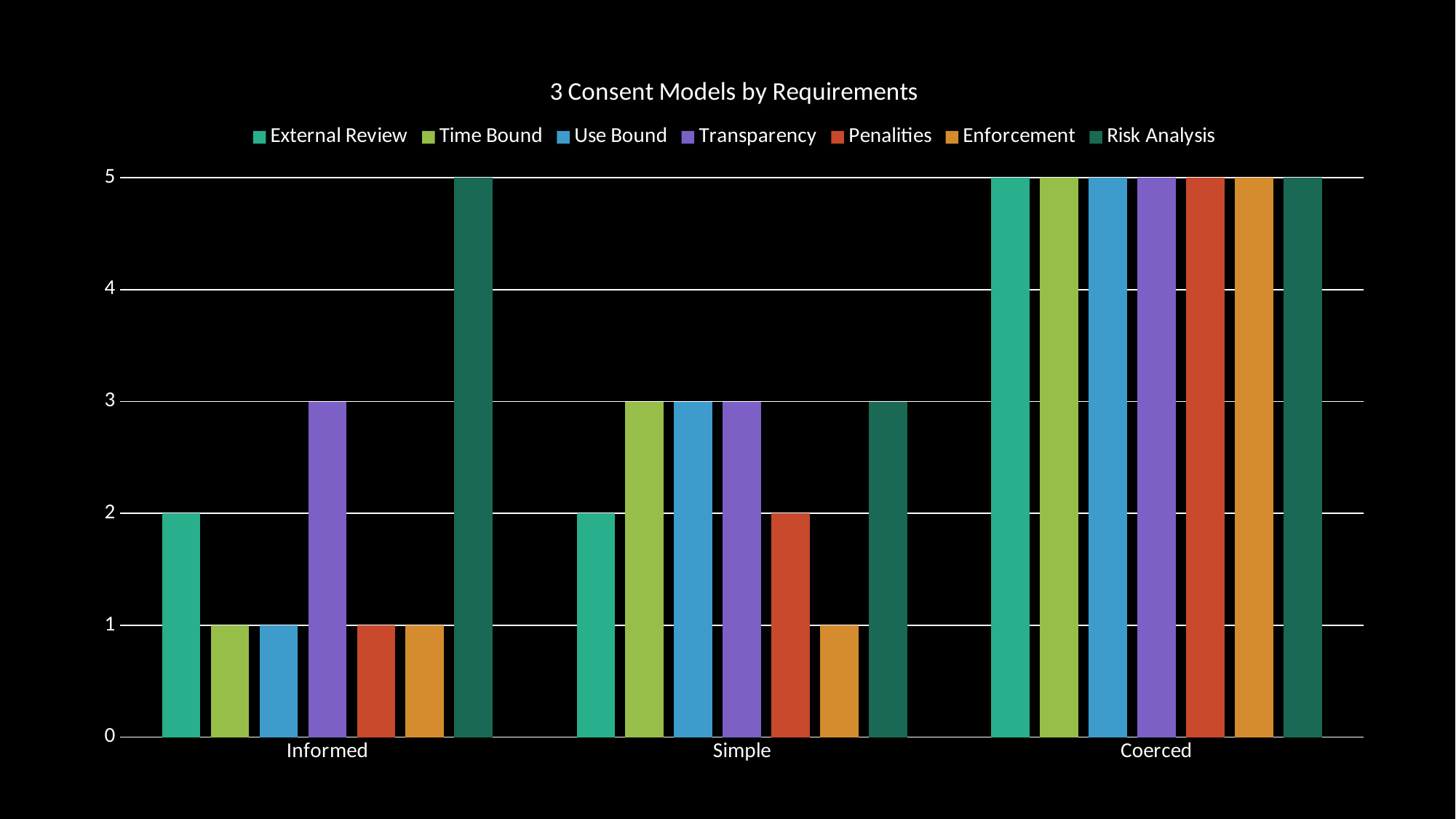
How many categories are shown on the x axis? 3 What is the value for Risk Analysis in the Informed category? 5 Which series has the highest value in the Informed category? Risk Analysis What is the title of the chart? 3 Consent Models by Requirements What is the value for Penalities in the Coerced category? 5 Which series has the lowest value in the Simple category? Enforcement What kind of chart is shown on the slide? bar chart What is the difference between the Risk Analysis values for Informed and Simple? 2 How many series does the legend list? 7 What is the value for Enforcement in the Simple category? 1 Which is larger: Time Bound for Informed or Time Bound for Simple? Time Bound for Simple What is the value for Transparency in the Informed category? 3